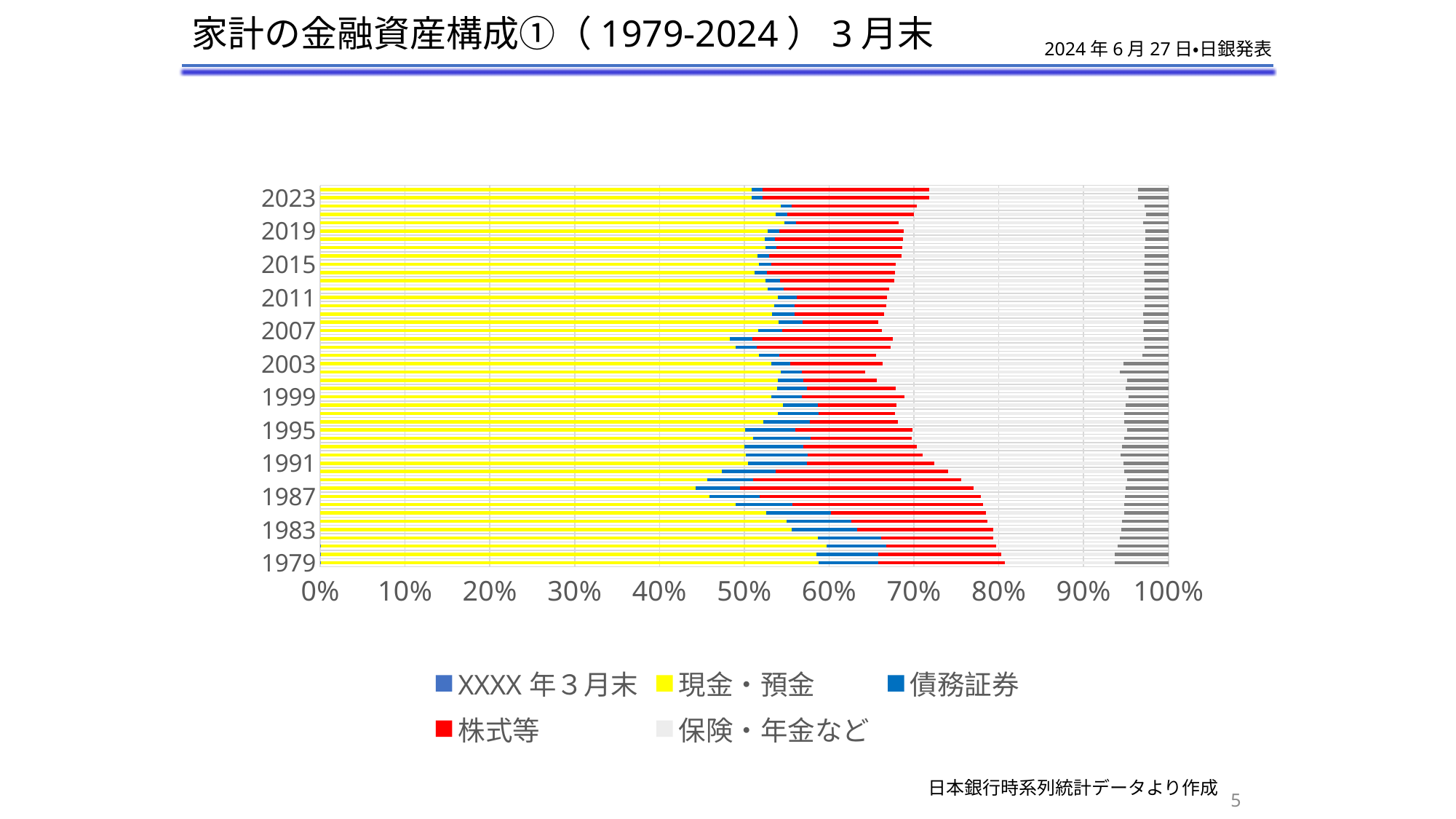
What kind of chart is shown on the slide? Stacked horizontal bar chart How many series does the legend list? 5 Which year has the larger 現金・預金 share, 1987 or 2011? 2011 Is the 現金・預金 share for 2011 greater or less than 50%? greater Which year has the larger 現金・預金 share, 1979 or 1987? 1979 What is the highest value shown on the horizontal axis? 100% Is the 現金・預金 share for 1979 greater or less than 50%? greater Is the 現金・預金 share for 1987 greater or less than 50%? less Which colour represents 株式等 in the chart? Red How many years (bars) are plotted in the chart? 46 What is the title of the chart on the slide? 家計の金融資産構成①（1979-2024）3月末